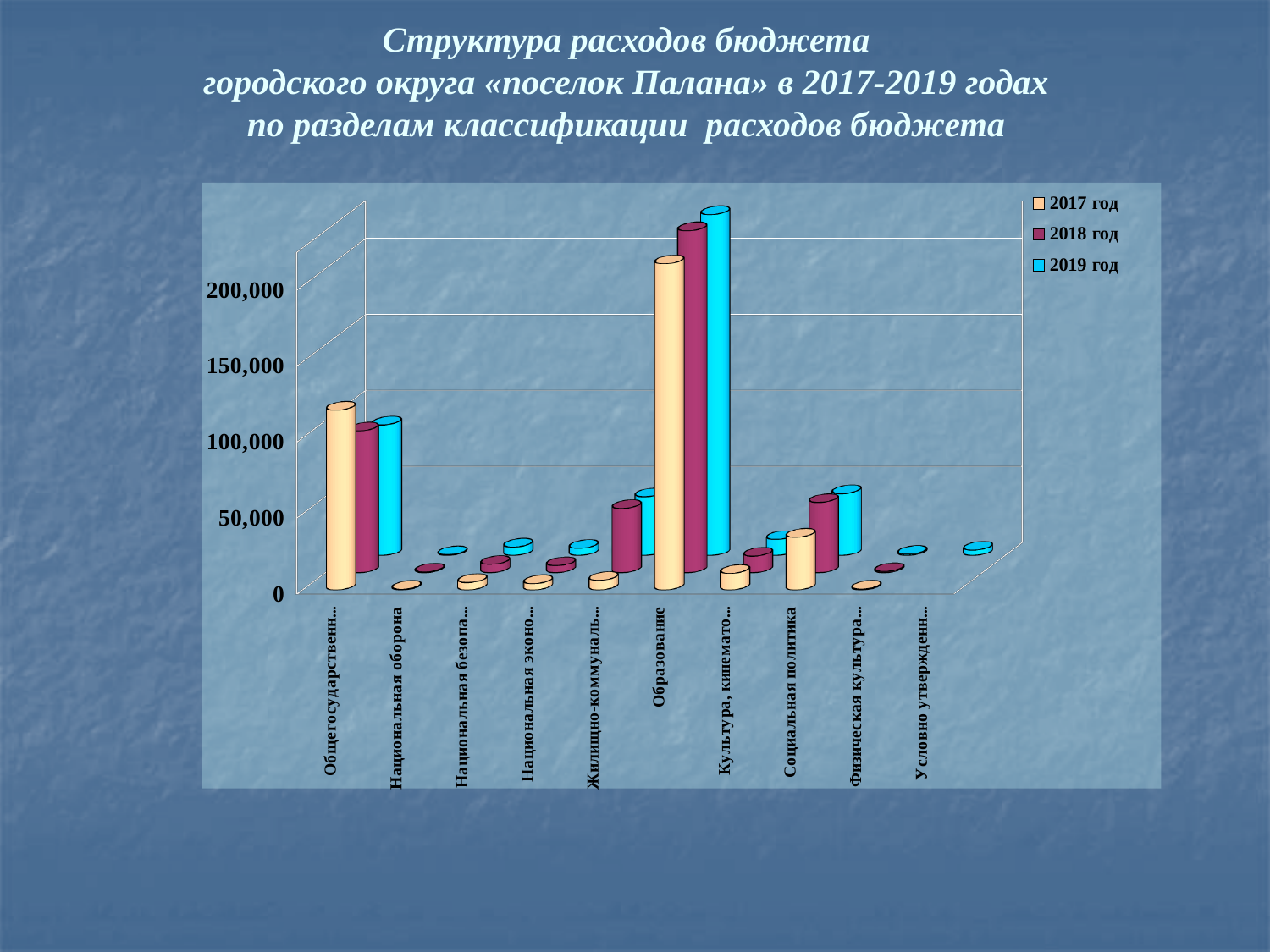
Is the value for Национальная оборона in 2017 год greater or less than 50,000? less Do the values for Образование rise or fall from 2017 год to 2019 год? rise Which category has the highest value for the 2017 год series? Образование What are the legend entries of the chart? 2017 год, 2018 год, 2019 год Which is larger in 2019 год: Образование or Жилищно-коммуналь...? Образование Is the value for Общегосударственн... in 2017 год greater or less than 50,000? greater Which category has the highest value for the 2019 год series? Образование How many categories are shown along the x axis? 10 Is the value for Образование in 2017 год greater or less than 150,000? greater Which is larger in 2017 год: Общегосударственн... or Социальная политика? Общегосударственн... How many series does the legend list? 3 What kind of chart is shown on the slide? bar chart